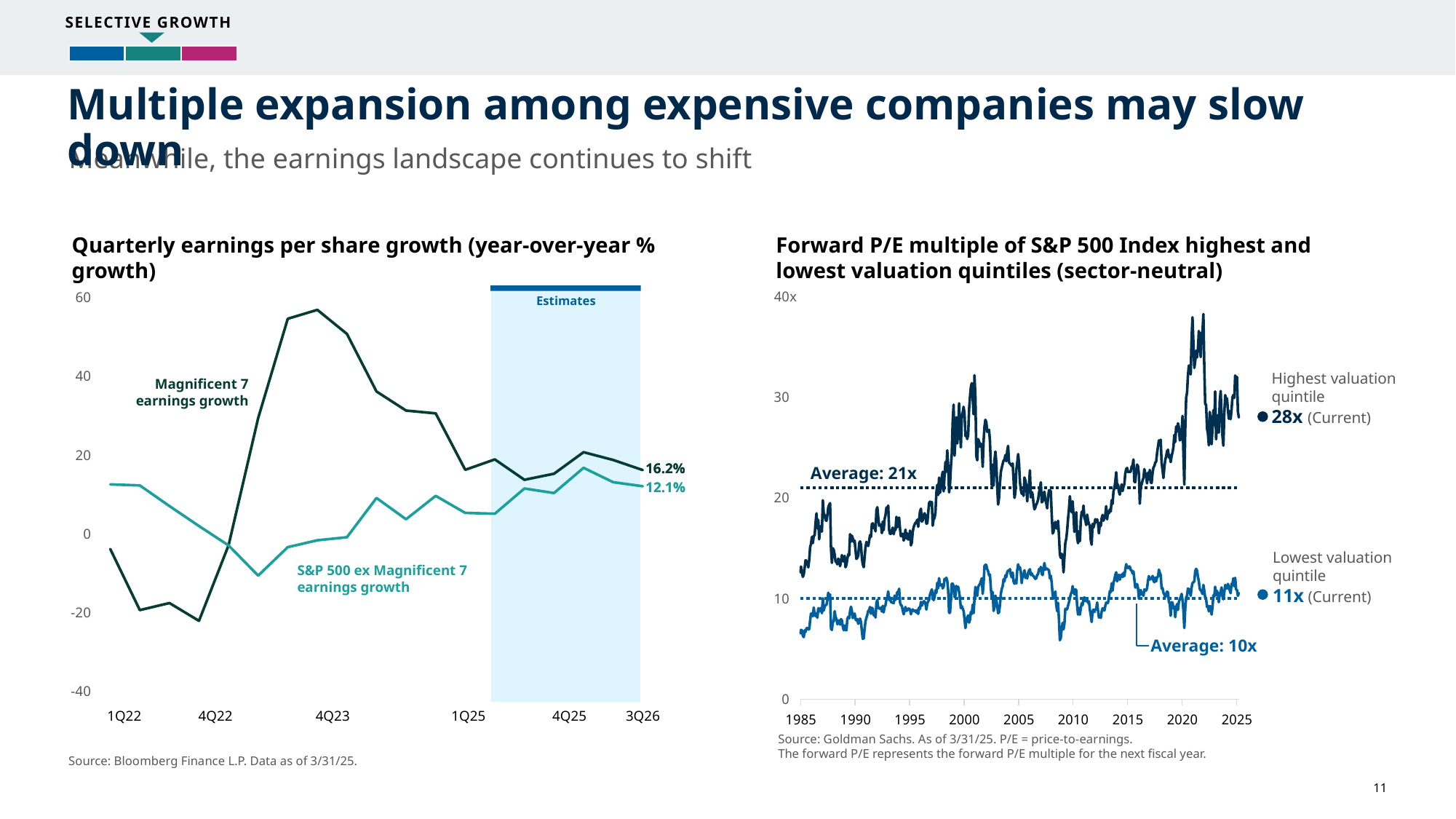
On the 'Quarterly earnings per share growth' chart, what is the difference between the 3Q26 estimates for Magnificent 7 and S&P 500 ex Magnificent 7 earnings growth? 4.1 percentage points On the 'Quarterly earnings per share growth' chart, which series has the higher value at 3Q26, Magnificent 7 or S&P 500 ex Magnificent 7? Magnificent 7 On the 'Forward P/E multiple of S&P 500 Index' chart, what is the long-term average forward P/E of the highest valuation quintile? 21x On the 'Quarterly earnings per share growth' chart, is the Magnificent 7 earnings growth value at 4Q23 greater or less than 40? greater On the 'Quarterly earnings per share growth' chart, what does the shaded region on the right represent? Estimates On the 'Quarterly earnings per share growth' chart, what is the estimated value for S&P 500 ex Magnificent 7 earnings growth at 3Q26? 12.1% On the 'Quarterly earnings per share growth' chart, is the S&P 500 ex Magnificent 7 earnings growth value at 1Q22 greater or less than 0? greater On the 'Forward P/E multiple of S&P 500 Index' chart, what is the current forward P/E of the highest valuation quintile? 28x On the 'Quarterly earnings per share growth' chart, what is the estimated value for Magnificent 7 earnings growth at 3Q26? 16.2% On the 'Forward P/E multiple of S&P 500 Index' chart, what is the current forward P/E of the lowest valuation quintile? 11x What kind of chart is the 'Quarterly earnings per share growth' chart? Line chart On the 'Forward P/E multiple of S&P 500 Index' chart, what is the difference between the current forward P/E of the highest and lowest valuation quintiles? 17x